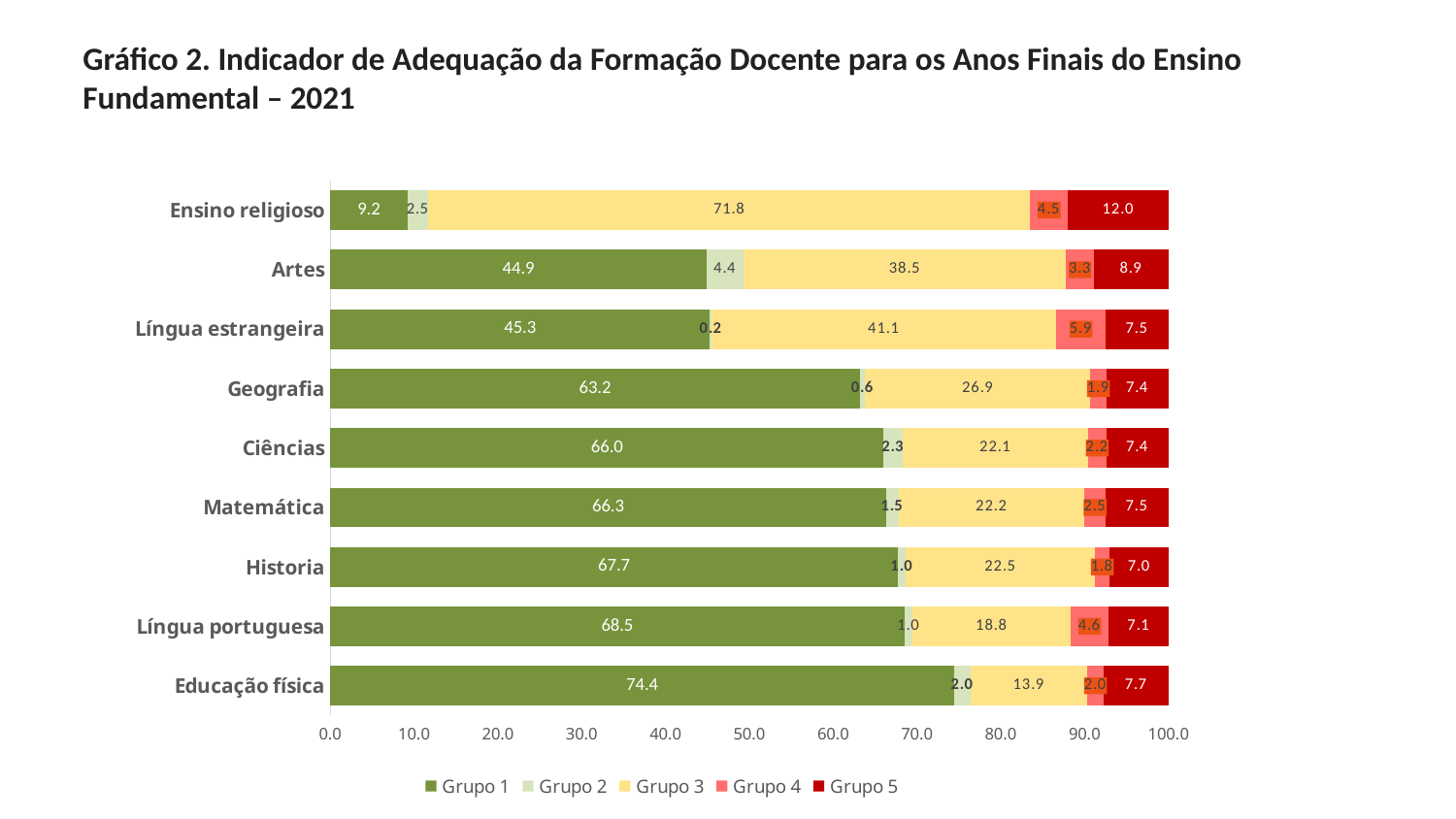
Which is larger, the Grupo 3 value for Artes or for Língua estrangeira? Língua estrangeira Which category has the lowest Grupo 1 value? Ensino religioso What kind of chart is shown on the slide? Stacked bar chart What is the difference between the Grupo 1 values for Educação física and Ensino religioso? 65.2 What is the Grupo 1 value for Educação física? 74.4 What is the Grupo 4 value for Língua estrangeira? 5.9 What is the Grupo 5 value for Artes? 8.9 What is the Grupo 3 value for Ensino religioso? 71.8 Which category has the highest Grupo 1 value? Educação física Which category has the highest Grupo 5 value? Ensino religioso How many series does the legend list? 5 How many categories are shown on the chart? 9